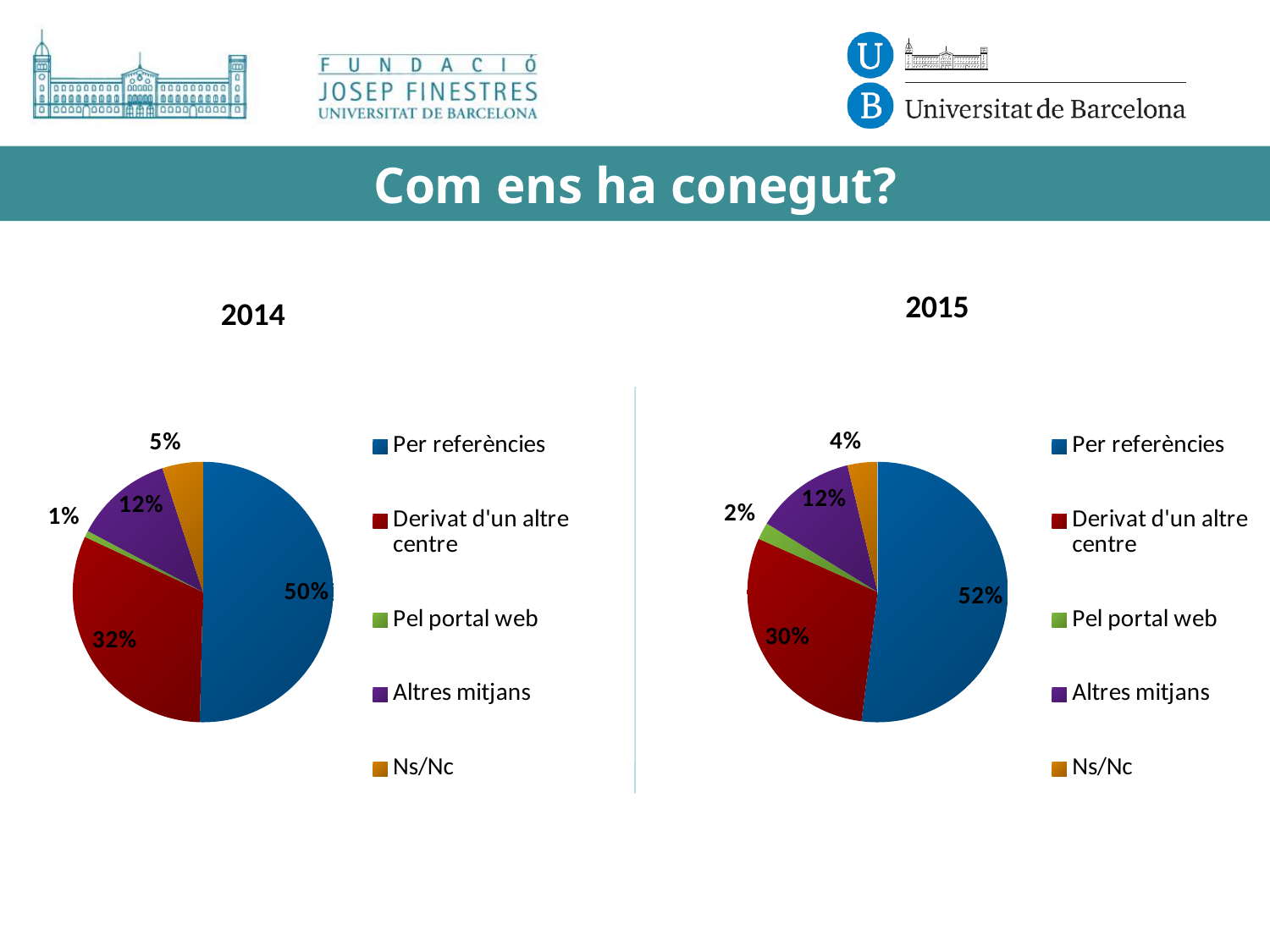
What is the title of the slide containing the two pie charts? Com ens ha conegut? In the 2015 pie chart, what share does 'Derivat d'un altre centre' have? 30% In the 2014 pie chart, which category has the smallest share? Pel portal web In the 2015 pie chart, which category has the largest share? Per referències In the 2015 pie chart, what share does 'Ns/Nc' have? 4% In the 2015 pie chart, which is larger: 'Altres mitjans' or 'Ns/Nc'? Altres mitjans What type of chart is used for the 2015 data? Pie chart How many slices does the 2014 pie chart have? 5 In the 2014 pie chart, what is the difference between the shares of 'Per referències' and 'Derivat d'un altre centre'? 18% In the 2014 pie chart, what share does 'Pel portal web' have? 1% In the 2015 pie chart, what colour represents 'Pel portal web'? Green In the 2014 pie chart, what share does 'Per referències' have? 50%